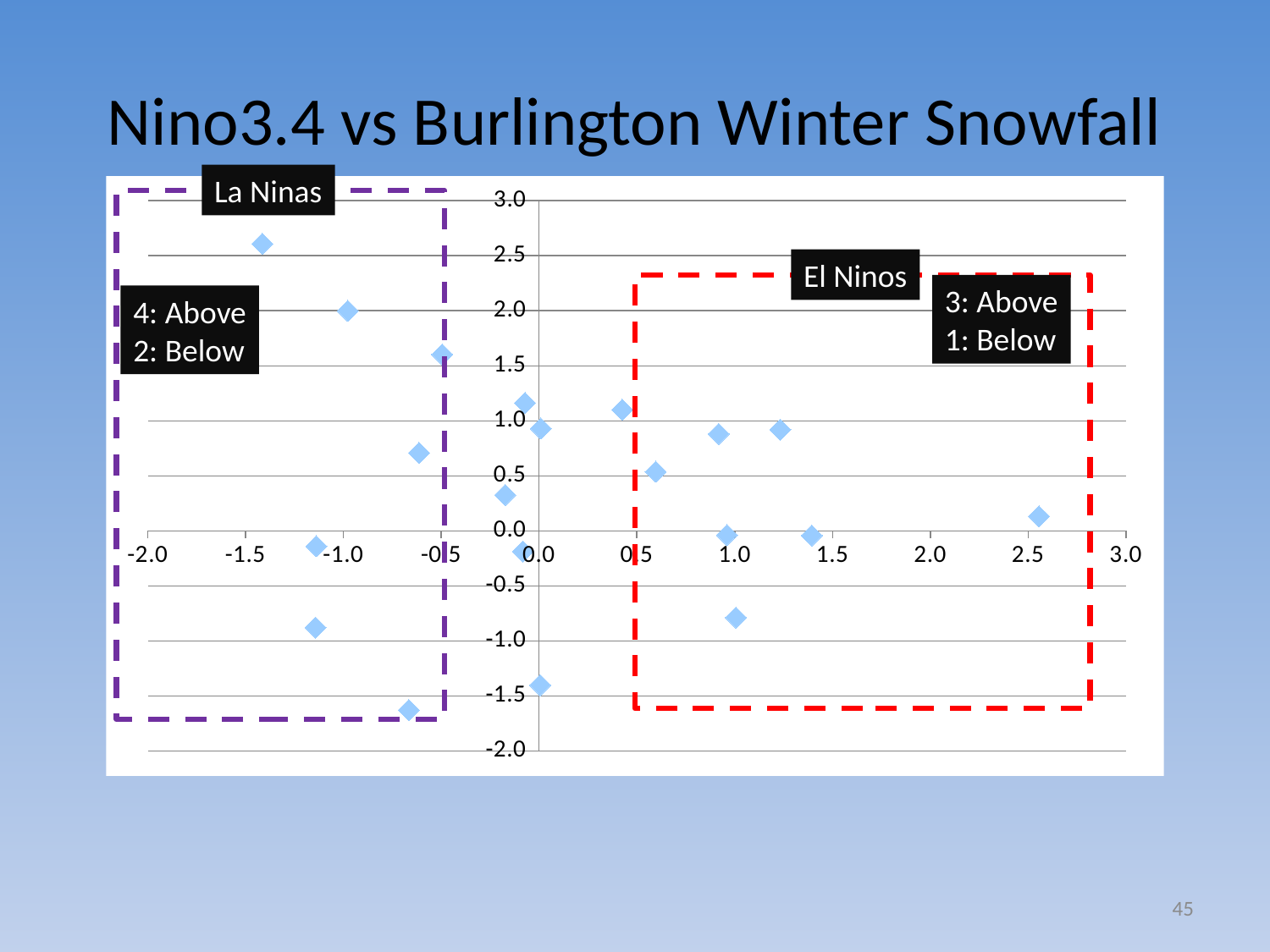
What is the highest value shown on the y axis? 3.0 According to the annotation in the La Ninas box, how many La Nina winters were above and how many below? 4 above, 2 below Is the y value of the lowest point on the chart greater or less than -1.5? less Is the x value of the rightmost point on the chart greater or less than 2.5? greater What is the title of the chart? Nino3.4 vs Burlington Winter Snowfall What kind of chart is shown on the slide? Scatter chart Which group has more winters marked as above: La Ninas or El Ninos? La Ninas What is the lowest value shown on the x axis? -2.0 Does the highest point on the chart fall inside the La Ninas box or the El Ninos box? La Ninas According to the annotation in the El Ninos box, how many El Nino winters were above and how many below? 3 above, 1 below What are the two labelled groups marked by dashed boxes on the chart? La Ninas and El Ninos Is the y value of the highest point on the chart greater or less than 2.5? greater